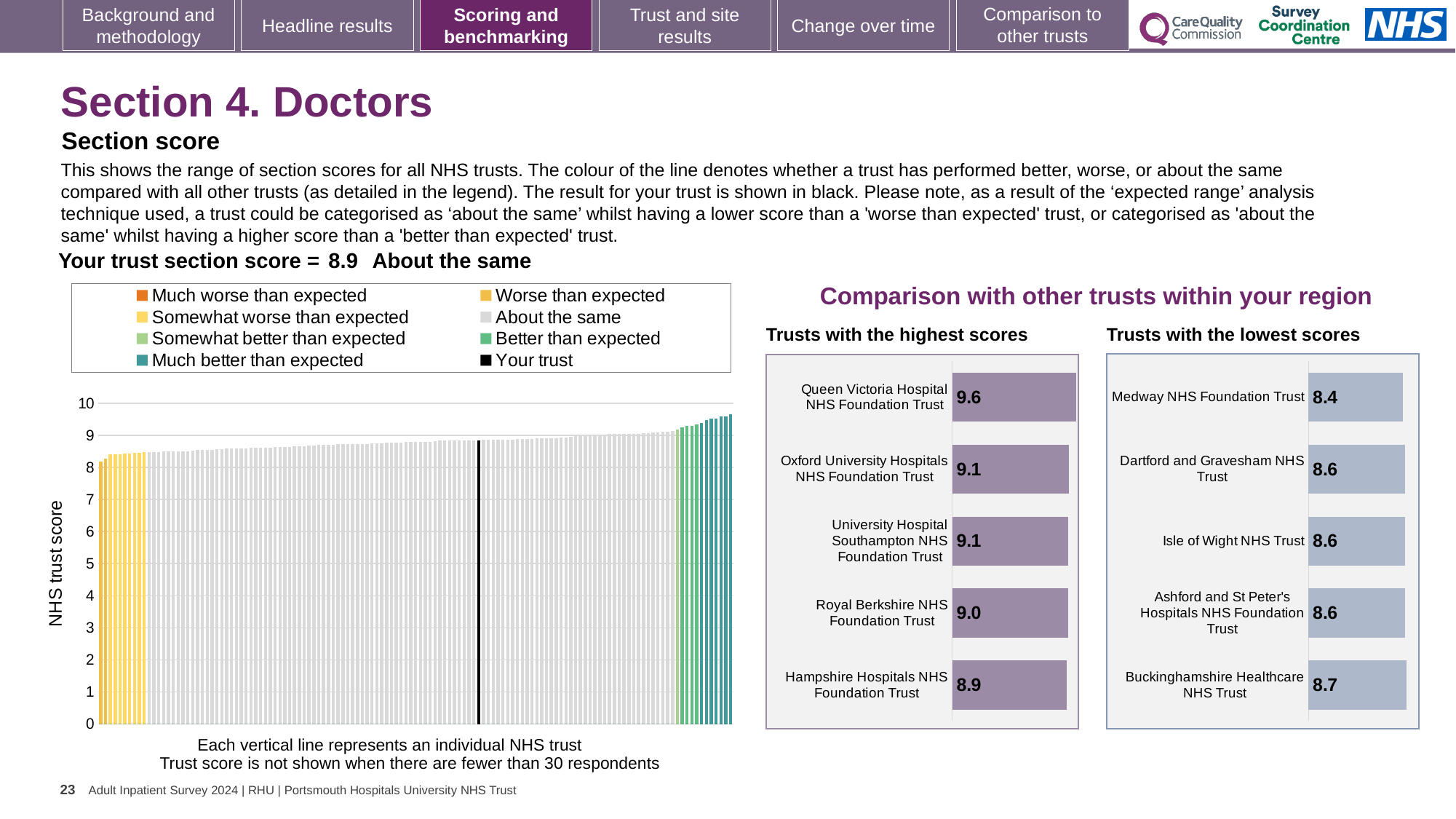
In the 'Trusts with the highest scores' chart, what is the score for Queen Victoria Hospital NHS Foundation Trust? 9.6 How many trusts are shown in the 'Trusts with the highest scores' chart? 5 In the 'Trusts with the lowest scores' chart, which trust has the lowest score? Medway NHS Foundation Trust In the 'Trusts with the lowest scores' chart, which has the larger score: Medway NHS Foundation Trust or Buckinghamshire Healthcare NHS Trust? Buckinghamshire Healthcare NHS Trust In the 'Trusts with the lowest scores' chart, what is the score for Medway NHS Foundation Trust? 8.4 In the 'Trusts with the highest scores' chart, which trust has the highest score? Queen Victoria Hospital NHS Foundation Trust In the 'Trusts with the highest scores' chart, what is the difference between the scores of Queen Victoria Hospital NHS Foundation Trust and Royal Berkshire NHS Foundation Trust? 0.6 In the main NHS trust score chart, do the trust scores rise or fall from left to right? Rise How many entries does the legend of the main NHS trust score chart list? 8 What kind of chart is the main chart showing the NHS trust scores for all trusts? Bar chart In the 'Trusts with the highest scores' chart, what is the score for Hampshire Hospitals NHS Foundation Trust? 8.9 In the 'Trusts with the lowest scores' chart, what is the score for Buckinghamshire Healthcare NHS Trust? 8.7